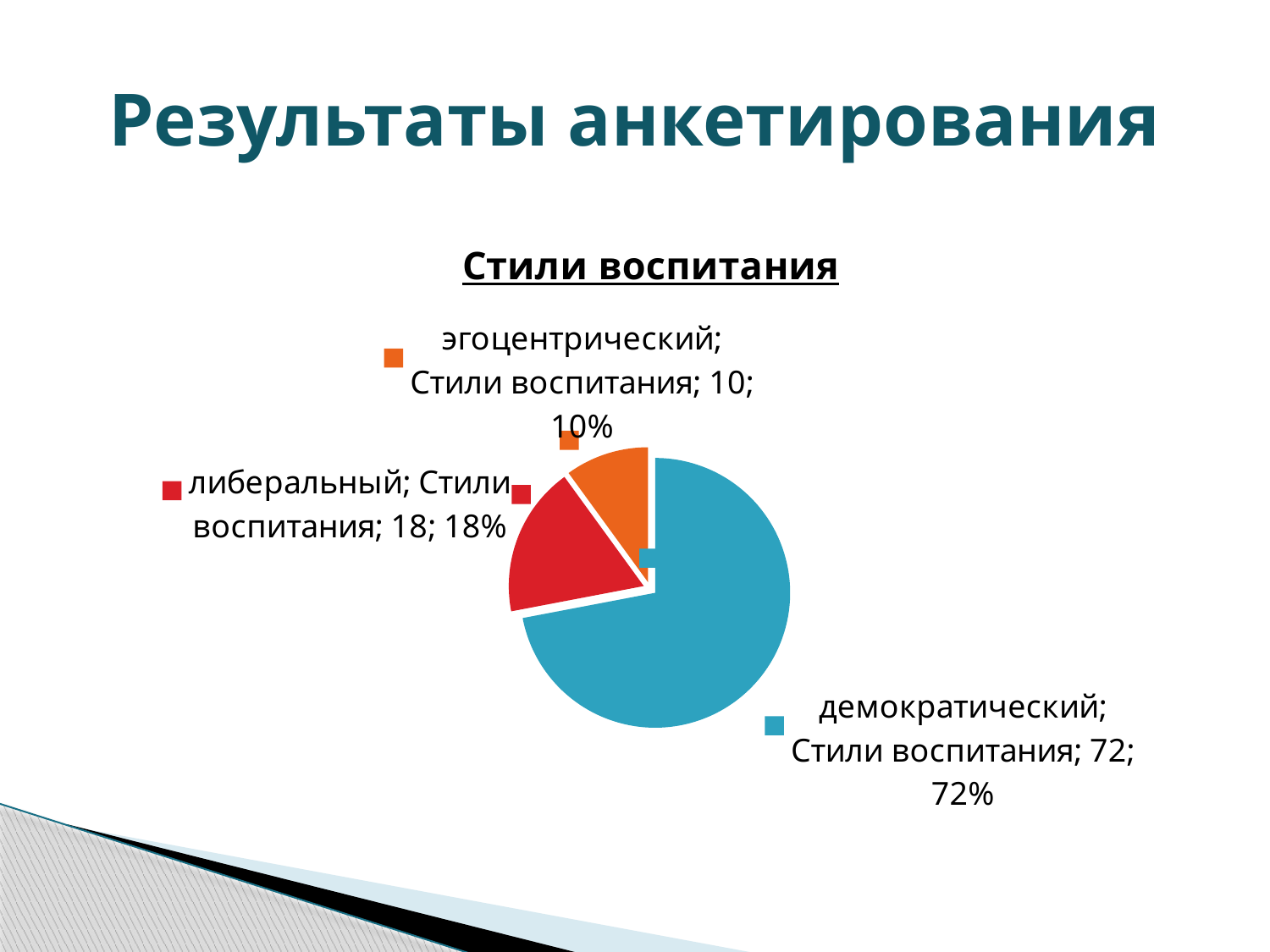
How many categories are shown in the pie chart? 3 Which category has the smallest slice? эгоцентрический What is the value for демократический? 72 Which category has the largest slice? демократический What share of the pie does демократический take? 72% What share of the pie does эгоцентрический take? 10% What is the difference between the values for демократический and либеральный? 54 What type of chart is shown on the slide? pie chart What is the value for эгоцентрический? 10 What is the title of the chart? Стили воспитания What is the value for либеральный? 18 Which is larger, либеральный or эгоцентрический? либеральный